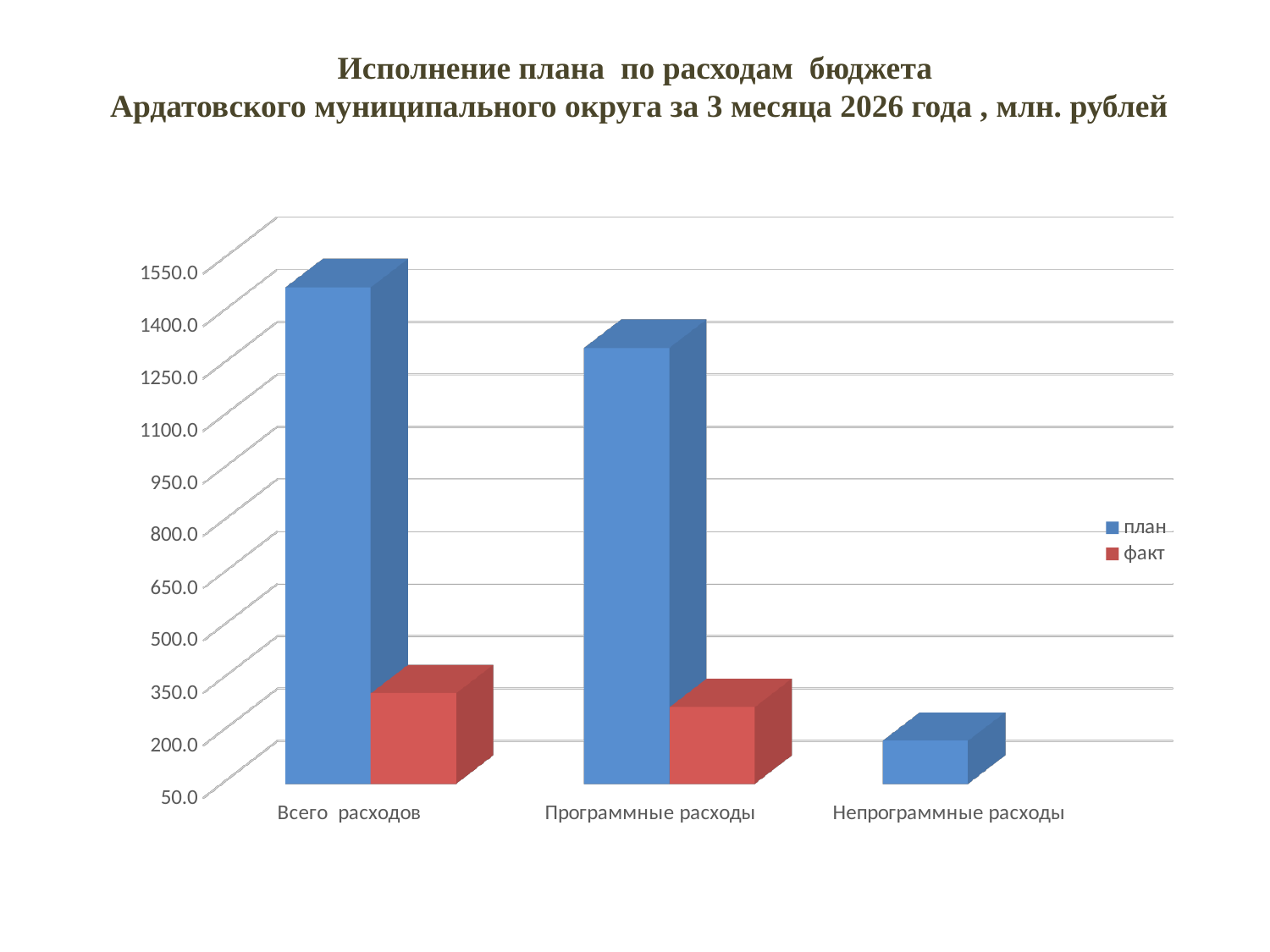
Is the план value for Всего расходов greater or less than 1400? greater Which category has the highest value for the план series? Всего расходов How many series does the chart's legend list? 2 How many categories are shown on the x axis of the chart? 3 What kind of chart is shown on the slide? bar chart Which is larger: the план value for Всего расходов or the план value for Программные расходы? Всего расходов Which category has the lowest value for the план series? Непрограммные расходы Is the план value for Программные расходы greater or less than 1400? less Is the факт value for Программные расходы greater or less than 350? less Which colour represents the факт series in the chart? red